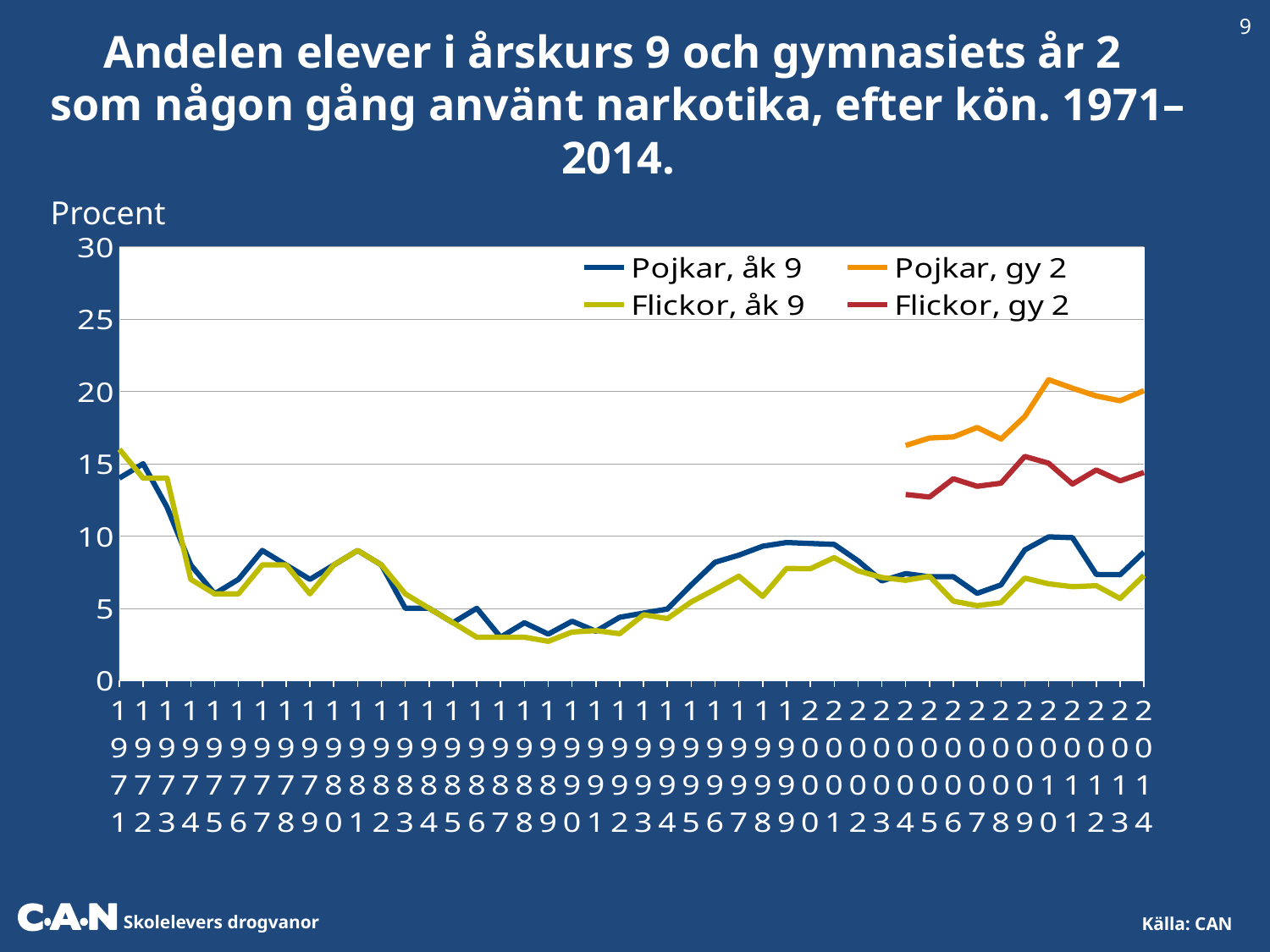
In 2014, which is larger: Pojkar, gy 2 or Flickor, gy 2? Pojkar, gy 2 What kind of chart is shown on the slide? line chart Which series has the lowest value in 2014? Flickor, åk 9 Which series has the highest value in 2014? Pojkar, gy 2 Does the Pojkar, åk 9 line generally rise or fall from 1971 to 1989? fall Does the Pojkar, gy 2 line generally rise or fall from 2004 to 2014? rise What are the four series named in the legend? Pojkar, åk 9; Pojkar, gy 2; Flickor, åk 9; Flickor, gy 2 Is the value for Flickor, gy 2 in 2004 greater or less than 15? less How many series does the legend list? 4 Is the value for Pojkar, gy 2 in 2014 greater or less than 15? greater What label is shown above the vertical axis? Procent Is the value for Pojkar, åk 9 in 1989 greater or less than 5? less